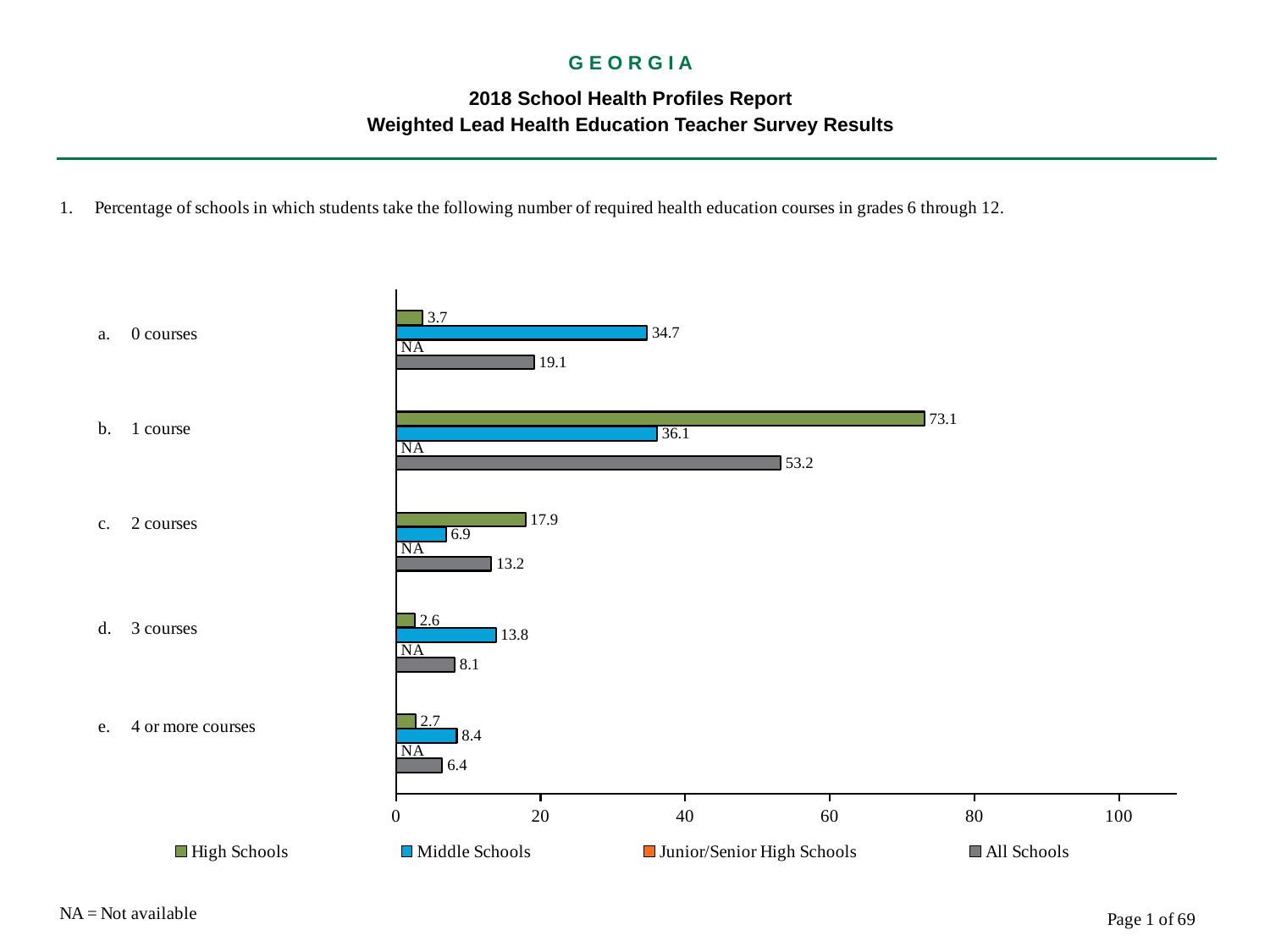
Which is larger in the '3 courses' category: the High Schools value or the Middle Schools value? Middle Schools What kind of chart is shown on the slide? bar chart Which category has the lowest value for All Schools? 4 or more courses How many categories are shown on the chart? 5 Is the All Schools value for '1 course' greater or less than 40? greater What is the value for All Schools in the '2 courses' category? 13.2 What is the difference between the High Schools and Middle Schools values in the '1 course' category? 37.0 Which category has the highest value for High Schools? 1 course What is the value for Middle Schools in the '0 courses' category? 34.7 What is the value for High Schools in the '1 course' category? 73.1 What is the value for Middle Schools in the '4 or more courses' category? 8.4 How many series does the legend list? 4